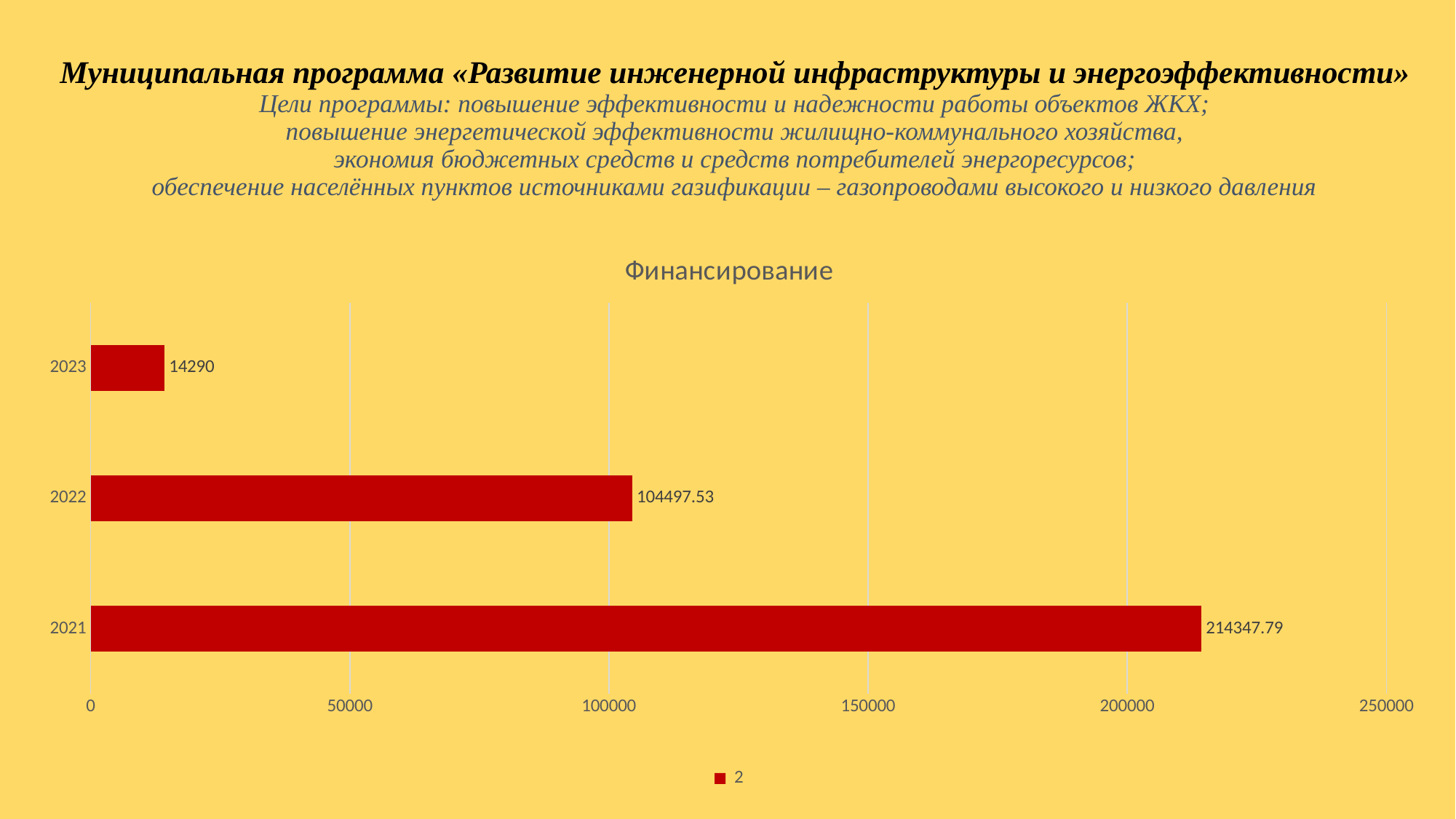
What is the value for 2021 in the Финансирование chart? 214347.79 Which year has the highest value in the Финансирование chart? 2021 What is the value for 2022 in the Финансирование chart? 104497.53 What is the difference between the values for 2022 and 2023 in the Финансирование chart? 90207.53 Is the value for 2021 in the Финансирование chart greater or less than 200000? greater What kind of chart is the Финансирование chart? bar chart Do the values in the Финансирование chart rise or fall from 2021 to 2023? fall How many years are shown in the Финансирование chart? 3 What is the value for 2023 in the Финансирование chart? 14290 What is the difference between the values for 2021 and 2022 in the Финансирование chart? 109850.26 Which year has the lowest value in the Финансирование chart? 2023 Which is larger in the Финансирование chart, the value for 2022 or the value for 2023? 2022